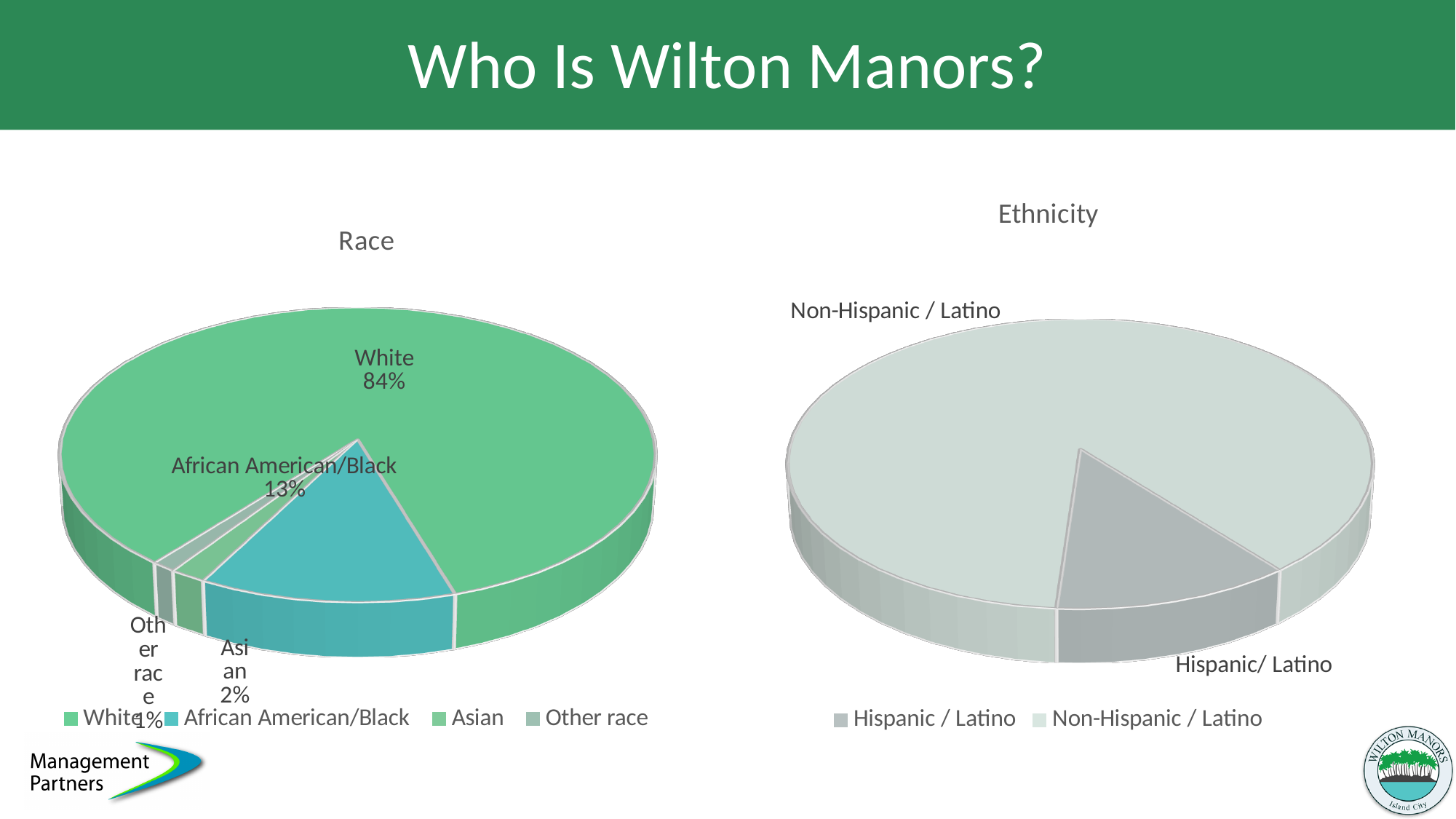
In the Race chart, what percentage is African American/Black? 13% What type of chart is the Ethnicity chart? Pie chart In the Ethnicity chart, which category has the larger share? Non-Hispanic / Latino In the Race chart, what is the difference in percentage points between White and African American/Black? 71 How many entries does the legend of the Ethnicity chart list? 2 In the Race chart, what percentage is Asian? 2% In the Race chart, which is larger, Asian or Other race? Asian In the Race chart, what percentage is White? 84% In the Race chart, what percentage is Other race? 1% How many categories does the Race chart show? 4 In the Race chart, which category has the smallest share? Other race In the Race chart, which category has the largest share? White